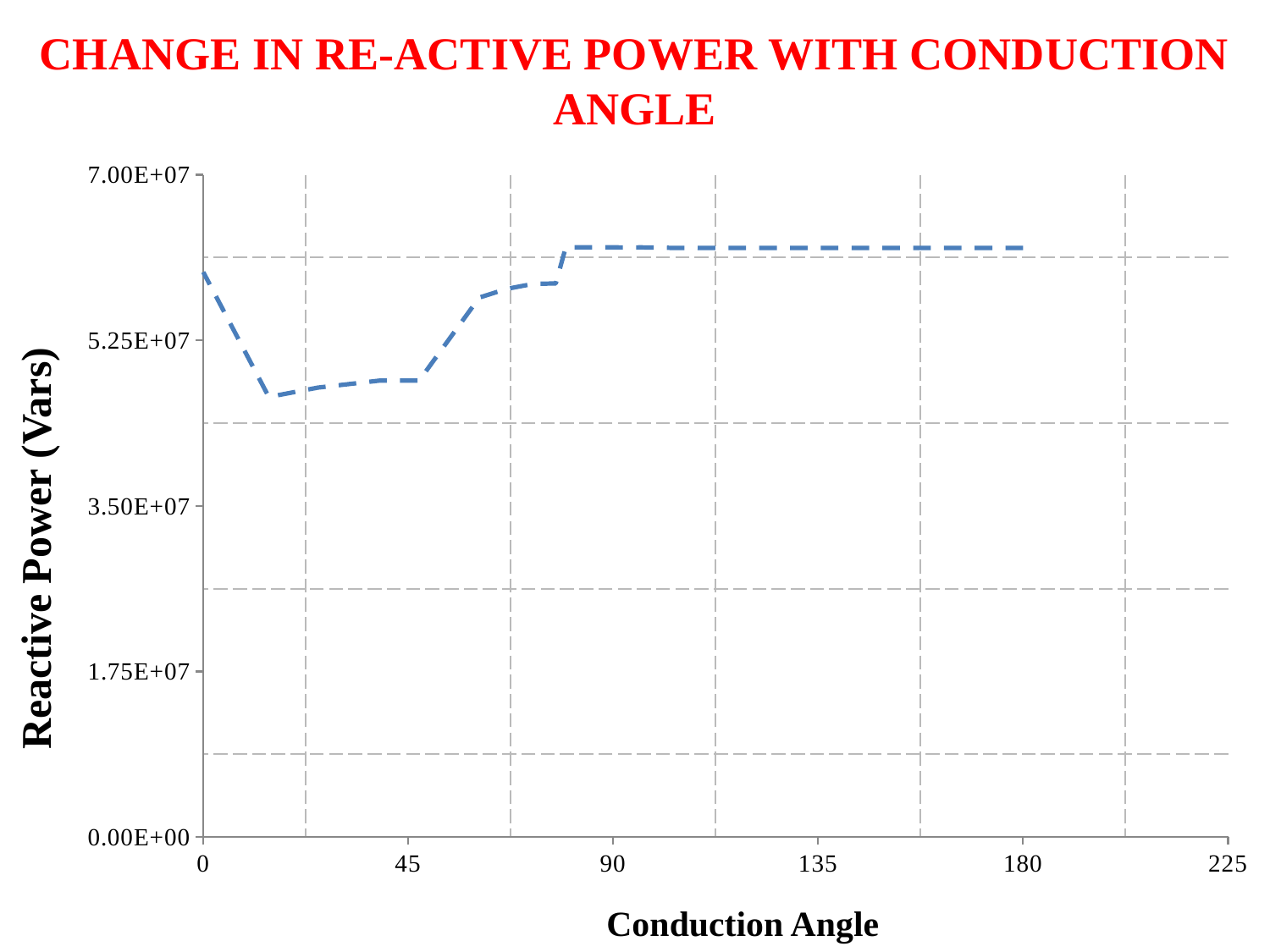
Is the reactive power at a conduction angle of 0 greater or less than 5.25E+07? greater What kind of chart is shown on the slide? line chart Is the reactive power at a conduction angle of 45 greater or less than 3.50E+07? greater Which has the higher reactive power, a conduction angle of 45 or a conduction angle of 135? 135 What is the label of the y axis? Reactive Power (Vars) Does the reactive power rise or fall as the conduction angle increases from 0 to about 15? falls Is the reactive power at a conduction angle of 45 greater or less than 5.25E+07? less Does the reactive power rise or fall as the conduction angle increases from 45 to 90? rises What is the title of the chart? CHANGE IN RE-ACTIVE POWER WITH CONDUCTION ANGLE Which has the higher reactive power, a conduction angle of 0 or a conduction angle of 180? 180